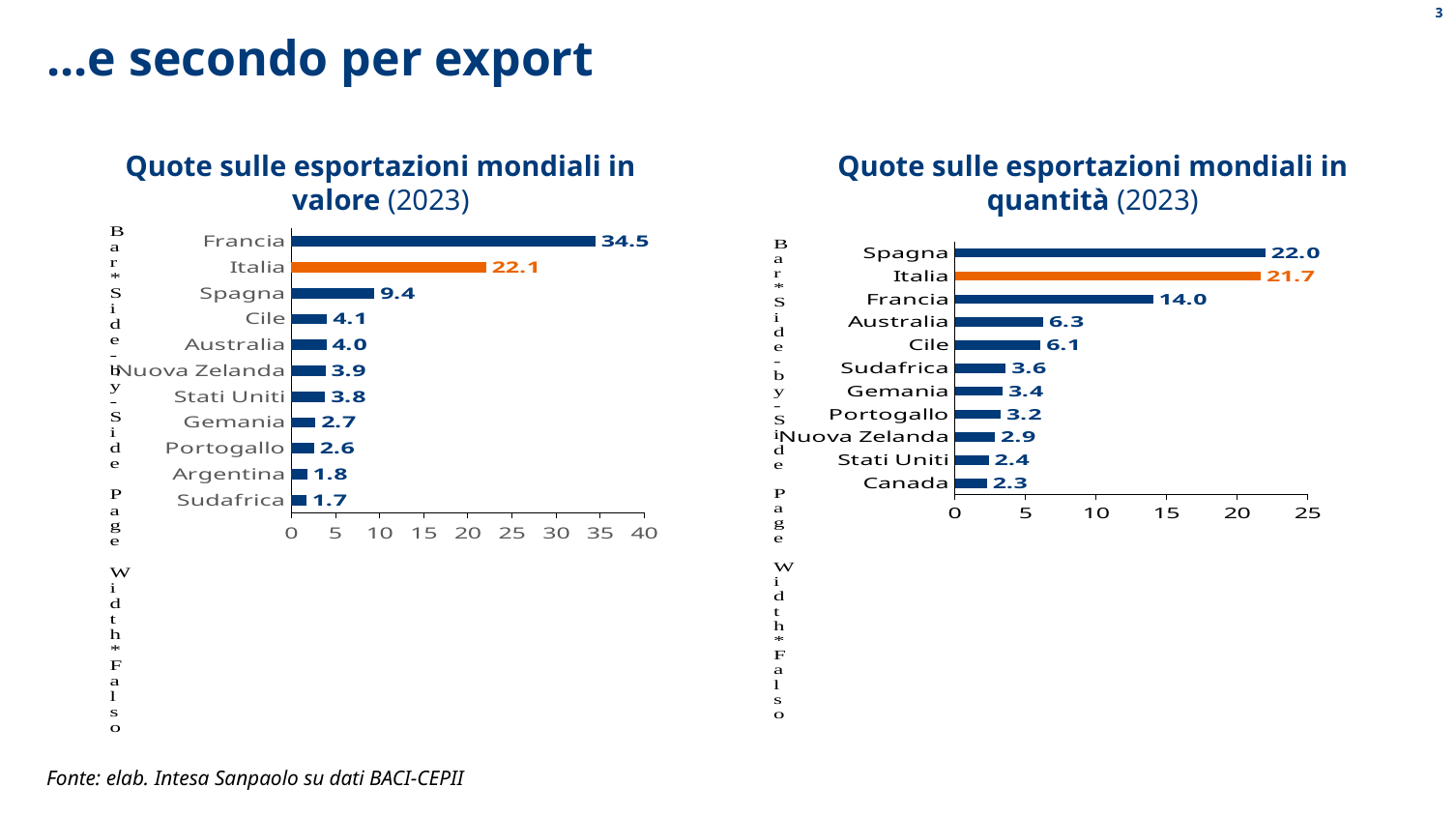
In the chart 'Quote sulle esportazioni mondiali in quantità (2023)', what is the value for Francia? 14.0 In the chart 'Quote sulle esportazioni mondiali in quantità (2023)', what is the difference between Italia and Francia? 7.7 In the chart 'Quote sulle esportazioni mondiali in valore (2023)', which country has the lowest value? Sudafrica In the chart 'Quote sulle esportazioni mondiali in quantità (2023)', which is larger, the value for Australia or the value for Sudafrica? Australia In the chart 'Quote sulle esportazioni mondiali in quantità (2023)', what is the value for Canada? 2.3 In the chart 'Quote sulle esportazioni mondiali in valore (2023)', what is the difference between Francia and Italia? 12.4 In the chart 'Quote sulle esportazioni mondiali in valore (2023)', how many countries are shown? 11 In the chart 'Quote sulle esportazioni mondiali in valore (2023)', what is the value for Francia? 34.5 In the chart 'Quote sulle esportazioni mondiali in valore (2023)', what is the value for Italia? 22.1 In the chart 'Quote sulle esportazioni mondiali in quantità (2023)', what is the value for Spagna? 22.0 In the chart 'Quote sulle esportazioni mondiali in quantità (2023)', which country has the highest value? Spagna What type of chart is 'Quote sulle esportazioni mondiali in valore (2023)'? Bar chart